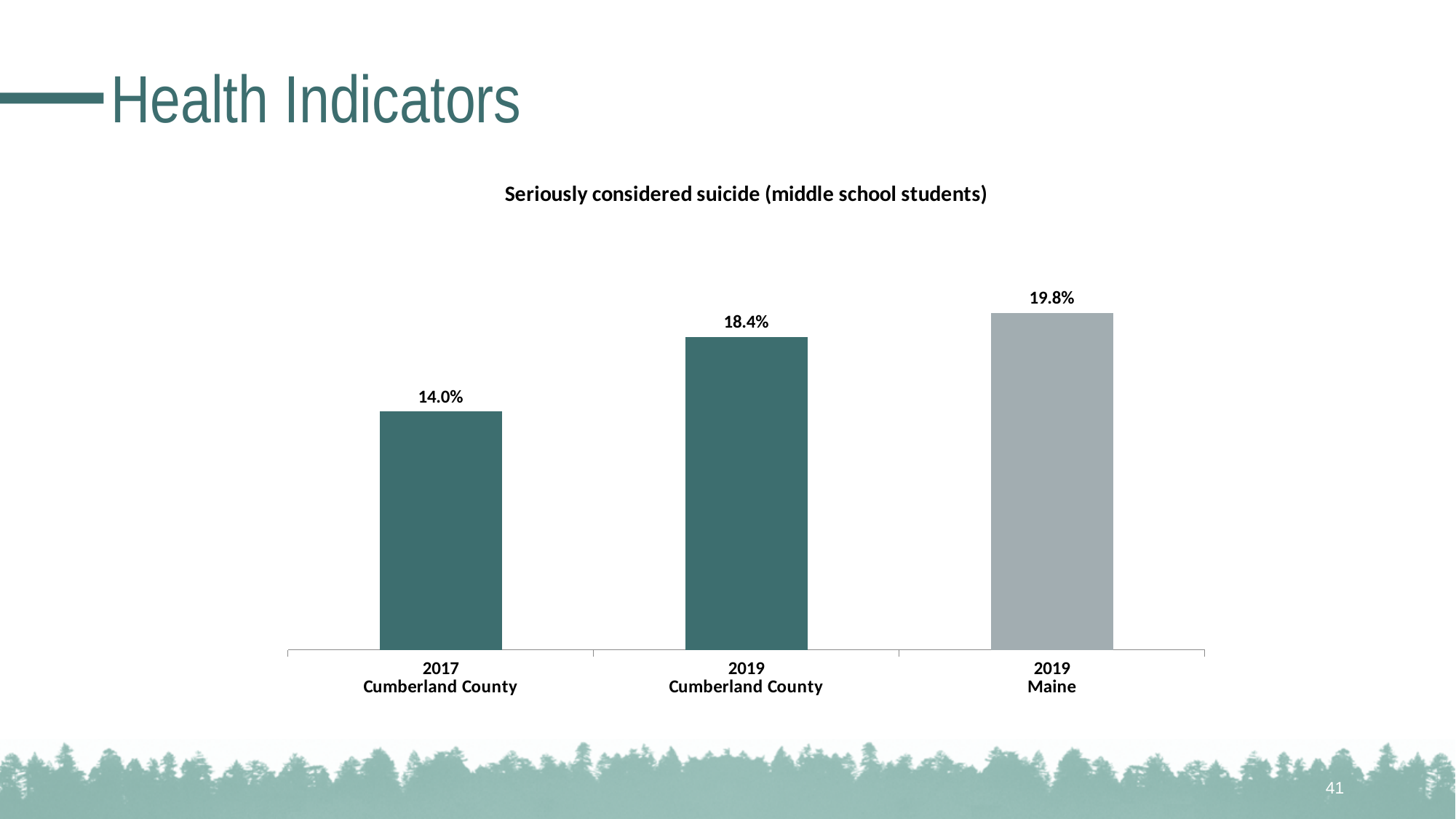
What is the value for 2019 Maine? 19.8% What is the value for 2017 Cumberland County? 14.0% Which category has the highest value? 2019 Maine What kind of chart is shown on the slide? Bar chart How many bars are shown in the chart? 3 Which category has the lowest value? 2017 Cumberland County What is the title of the chart? Seriously considered suicide (middle school students) What is the difference between the 2019 Cumberland County value and the 2017 Cumberland County value? 4.4% What is the value for 2019 Cumberland County? 18.4% Do the values rise or fall from left to right across the chart? Rise What is the difference between the 2019 Maine value and the 2019 Cumberland County value? 1.4% Which is larger, the value for 2019 Cumberland County or the value for 2019 Maine? 2019 Maine